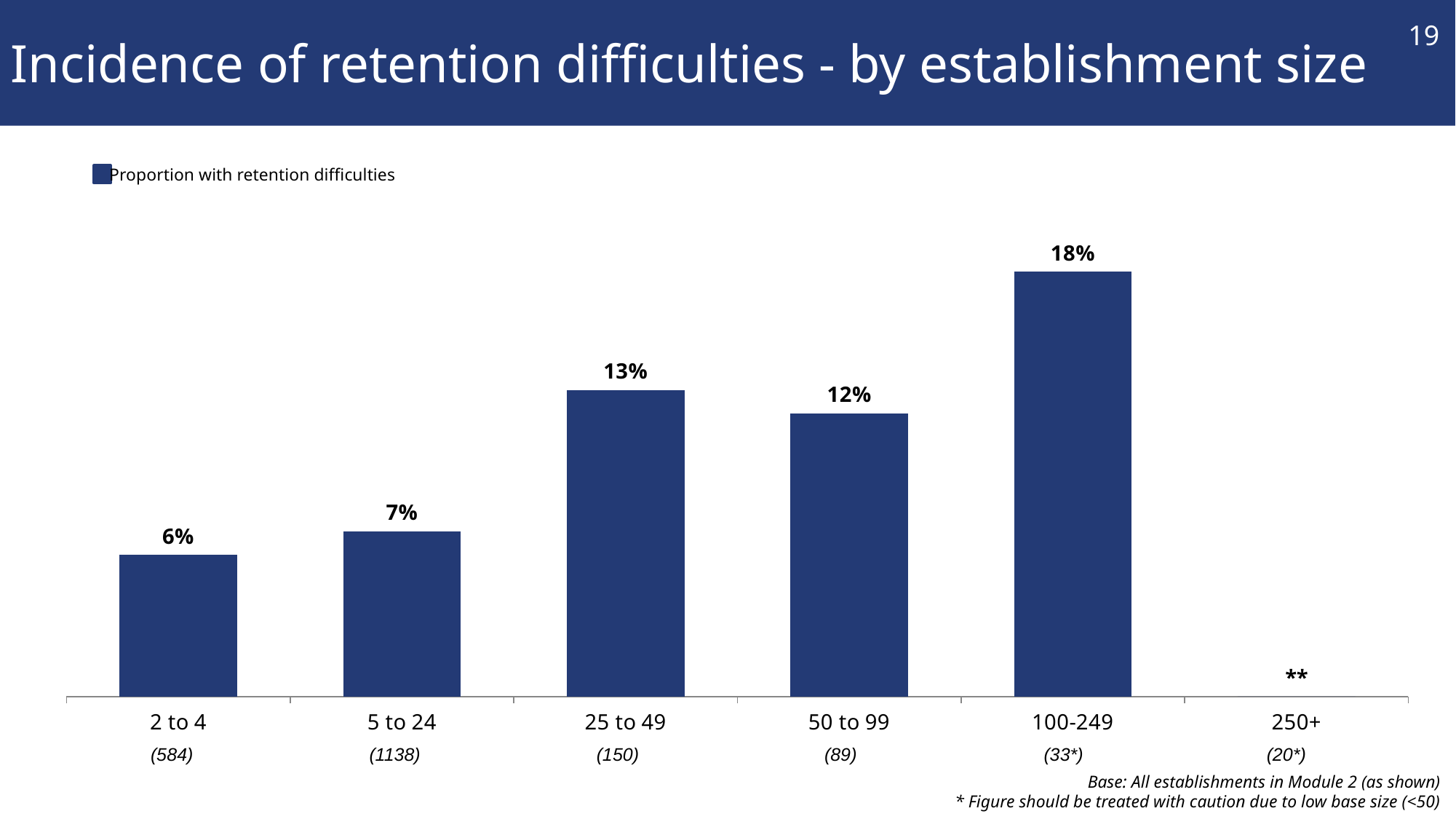
What is the proportion with retention difficulties for establishments with 2 to 4 employees? 6% What is the proportion with retention difficulties for establishments with 100-249 employees? 18% What is the base size shown for the 5 to 24 category? 1138 How many series does the legend list? 1 What is the legend entry for the series shown in the chart? Proportion with retention difficulties How many establishment size categories are shown on the x axis? 6 What is the difference in percentage points between the 100-249 and 50 to 99 categories? 6 Which has a higher proportion with retention difficulties: 25 to 49 or 50 to 99? 25 to 49 Among the categories with a plotted value, which establishment size has the lowest proportion with retention difficulties? 2 to 4 What kind of chart is shown on the slide? Bar chart What is the proportion with retention difficulties for establishments with 25 to 49 employees? 13% Which establishment size category has the highest proportion with retention difficulties? 100-249